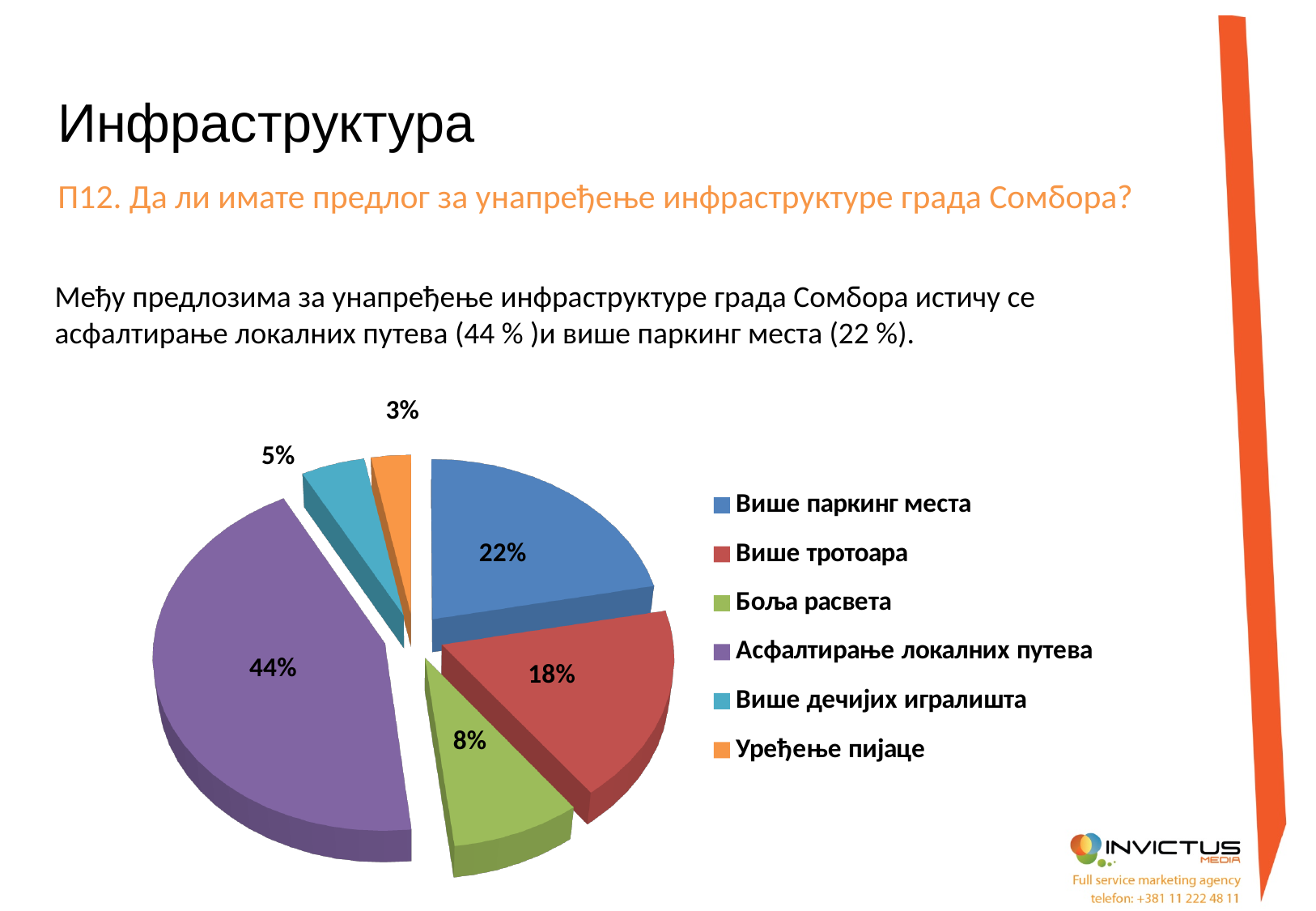
Which is larger, the value for "Више тротоара" or the value for "Боља расвета"? Више тротоара What is the value for "Више паркинг места"? 22% How many categories does the legend of the pie chart list? 6 Which category has the smallest slice of the pie? Уређење пијаце What is the value for "Боља расвета"? 8% What is the value for "Више дечијих игралишта"? 5% What is the value for "Уређење пијаце"? 3% What kind of chart is shown on the slide? pie chart Which category has the largest slice of the pie? Асфалтирање локалних путева What is the value for "Више тротоара"? 18% What share of the pie does "Асфалтирање локалних путева" have? 44% What is the difference between the values for "Асфалтирање локалних путева" and "Више паркинг места"? 22%